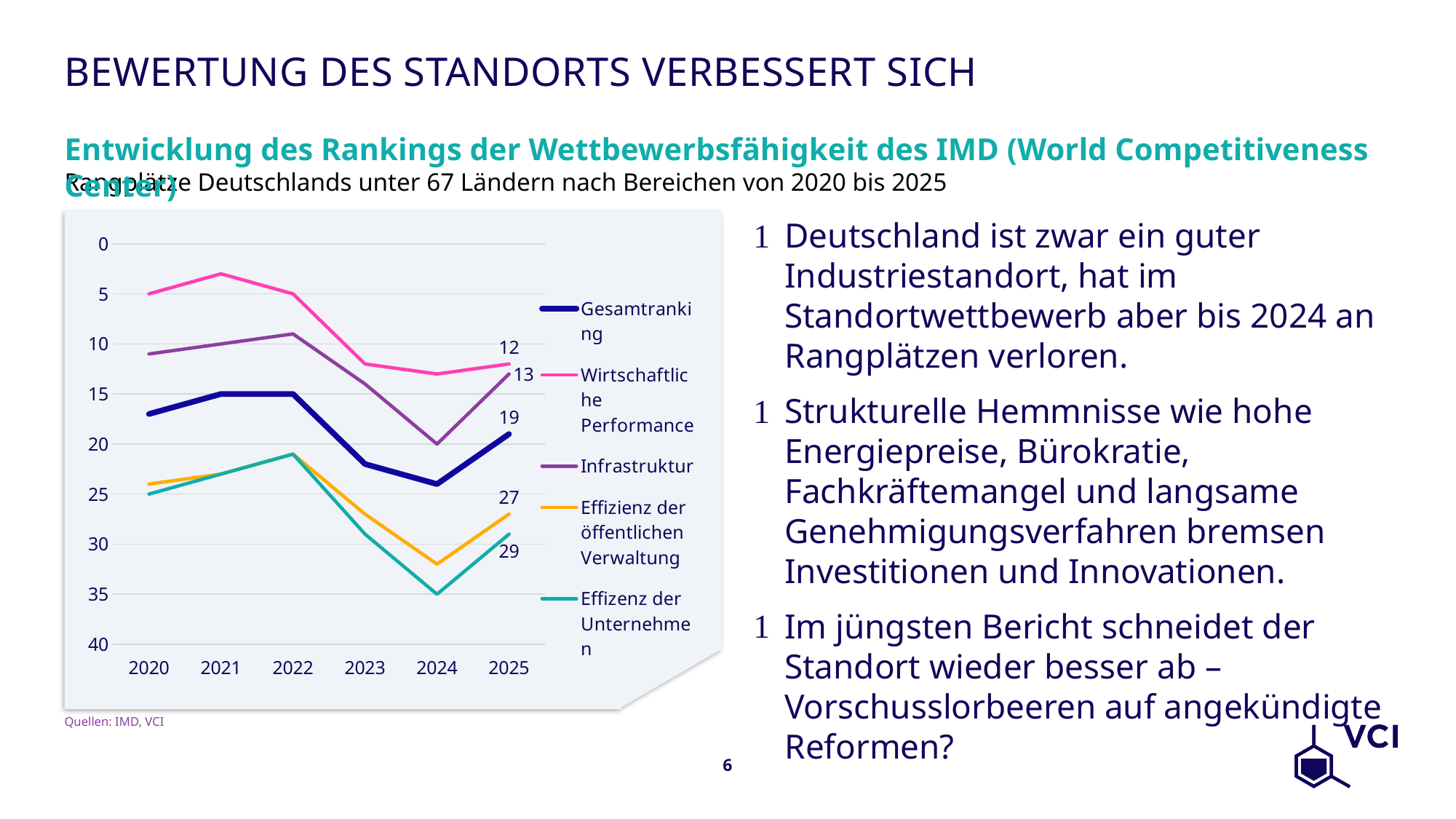
What is the value for Effizenz der Unternehmen in 2025? 29 What is the difference between the 2025 values for Effizenz der Unternehmen and Wirtschaftliche Performance? 17 How many series does the legend list? 5 Which series has the lowest value in 2025? Wirtschaftliche Performance What is the value for Infrastruktur in 2025? 13 Is the value for Wirtschaftliche Performance in 2021 greater or less than 5? less What is the value for Wirtschaftliche Performance in 2025? 12 What is the value for Effizienz der öffentlichen Verwaltung in 2025? 27 What is the value for Gesamtranking in 2025? 19 Is the value for Gesamtranking in 2024 greater or less than 20? greater What kind of chart is shown on the slide? line chart Which series has the highest value in 2025? Effizenz der Unternehmen